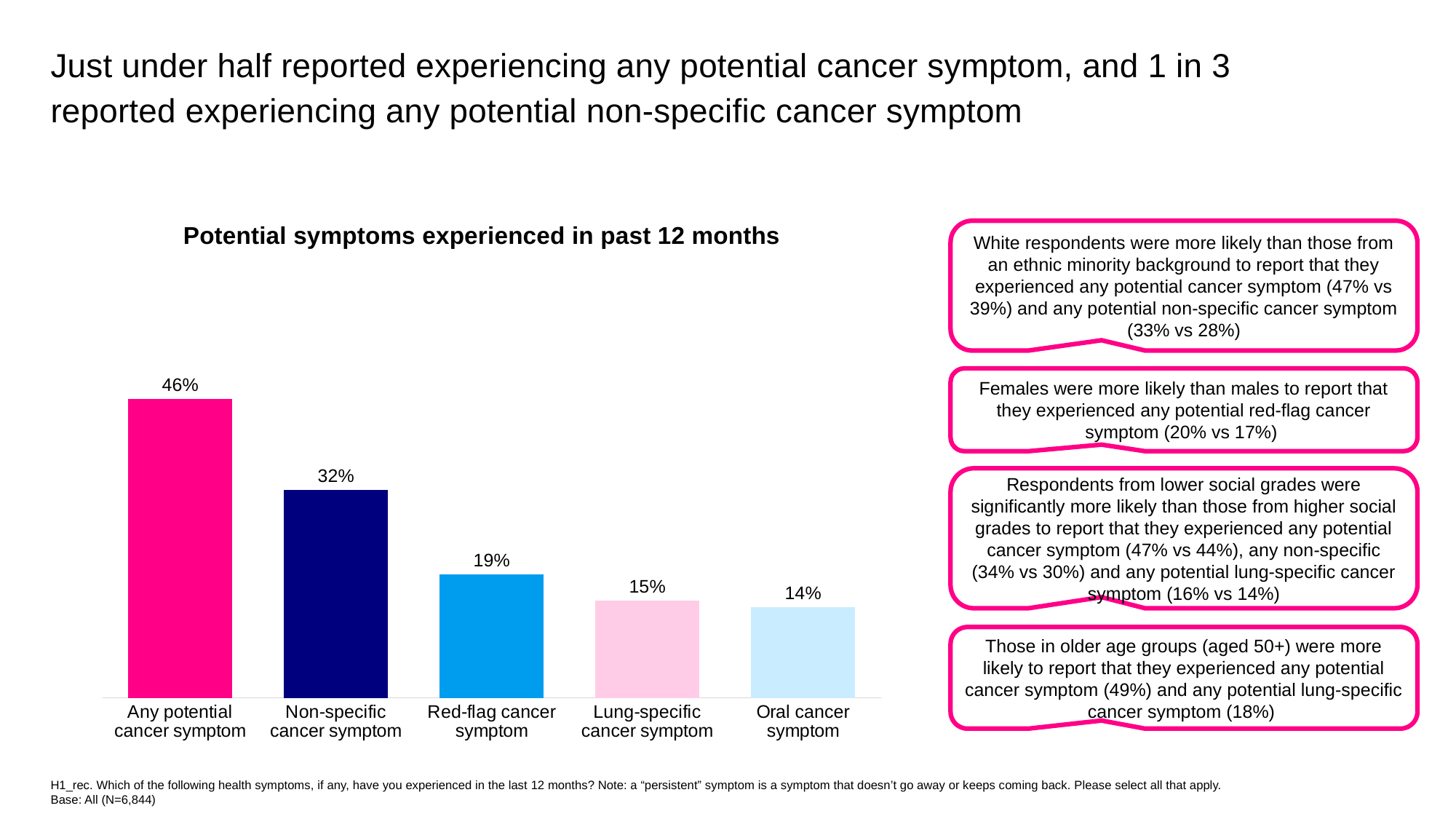
Do the values rise or fall from left to right across the categories? Fall What is the difference between the values for any potential cancer symptom and non-specific cancer symptom? 14% Which is larger: the value for red-flag cancer symptom or lung-specific cancer symptom? Red-flag cancer symptom What is the value for oral cancer symptom? 14% How many categories are shown in the chart? 5 Which category has the highest value in the chart? Any potential cancer symptom What percentage reported a red-flag cancer symptom? 19% Which category has the lowest value in the chart? Oral cancer symptom What is the value shown for non-specific cancer symptom? 32% What percentage of respondents reported experiencing any potential cancer symptom? 46% What kind of chart is shown on the slide? Bar chart What is the title of the chart? Potential symptoms experienced in past 12 months